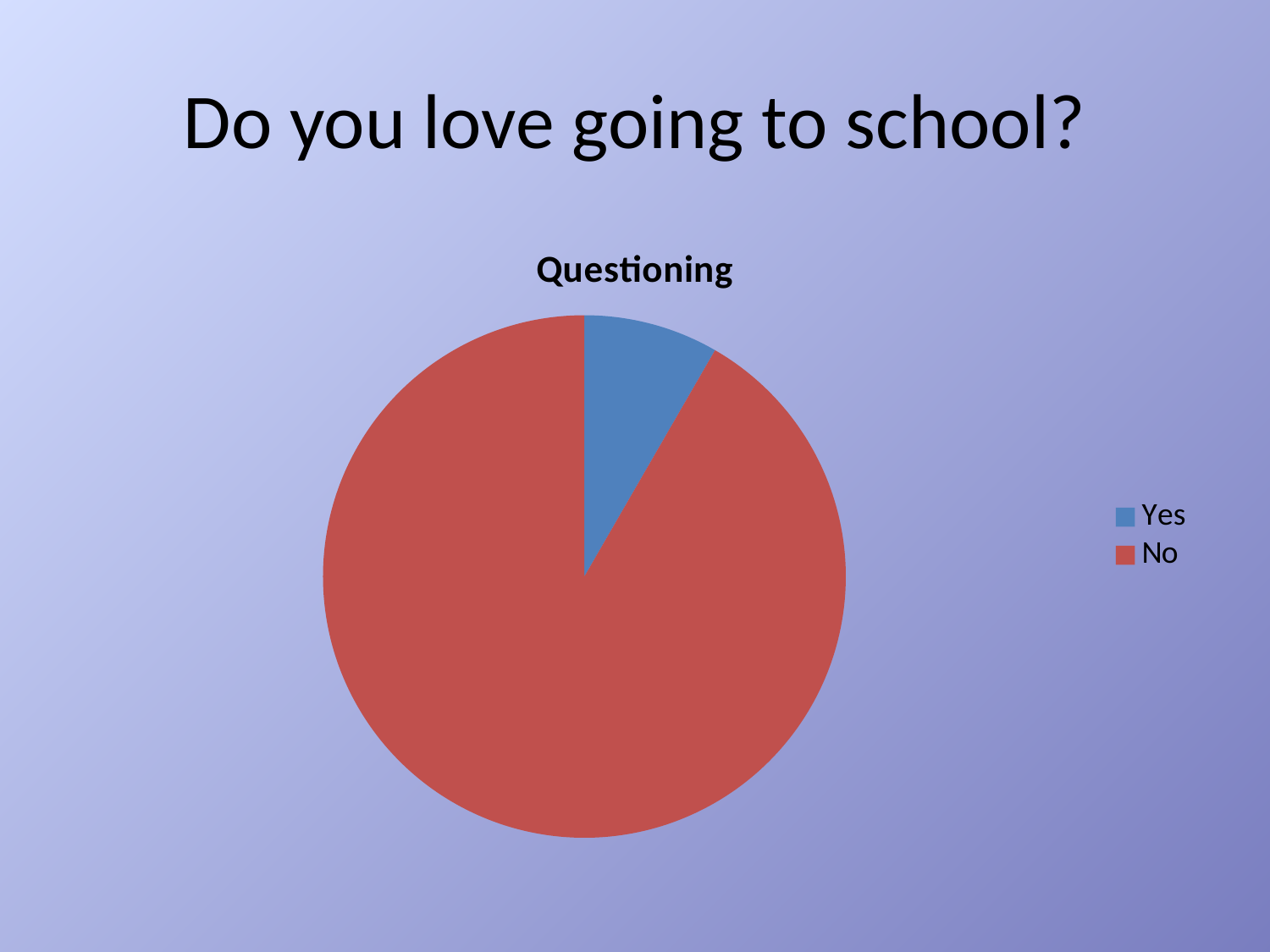
How many entries does the chart's legend list? 2 How many slices does the pie chart have? 2 Which slice is larger, Yes or No? No What colour is the slice for No? red What is the title of the chart? Questioning Which category has the largest slice of the pie? No Which category has the smallest slice of the pie? Yes Does the Yes slice take up more or less than half of the pie? less What kind of chart is shown on the slide? pie chart